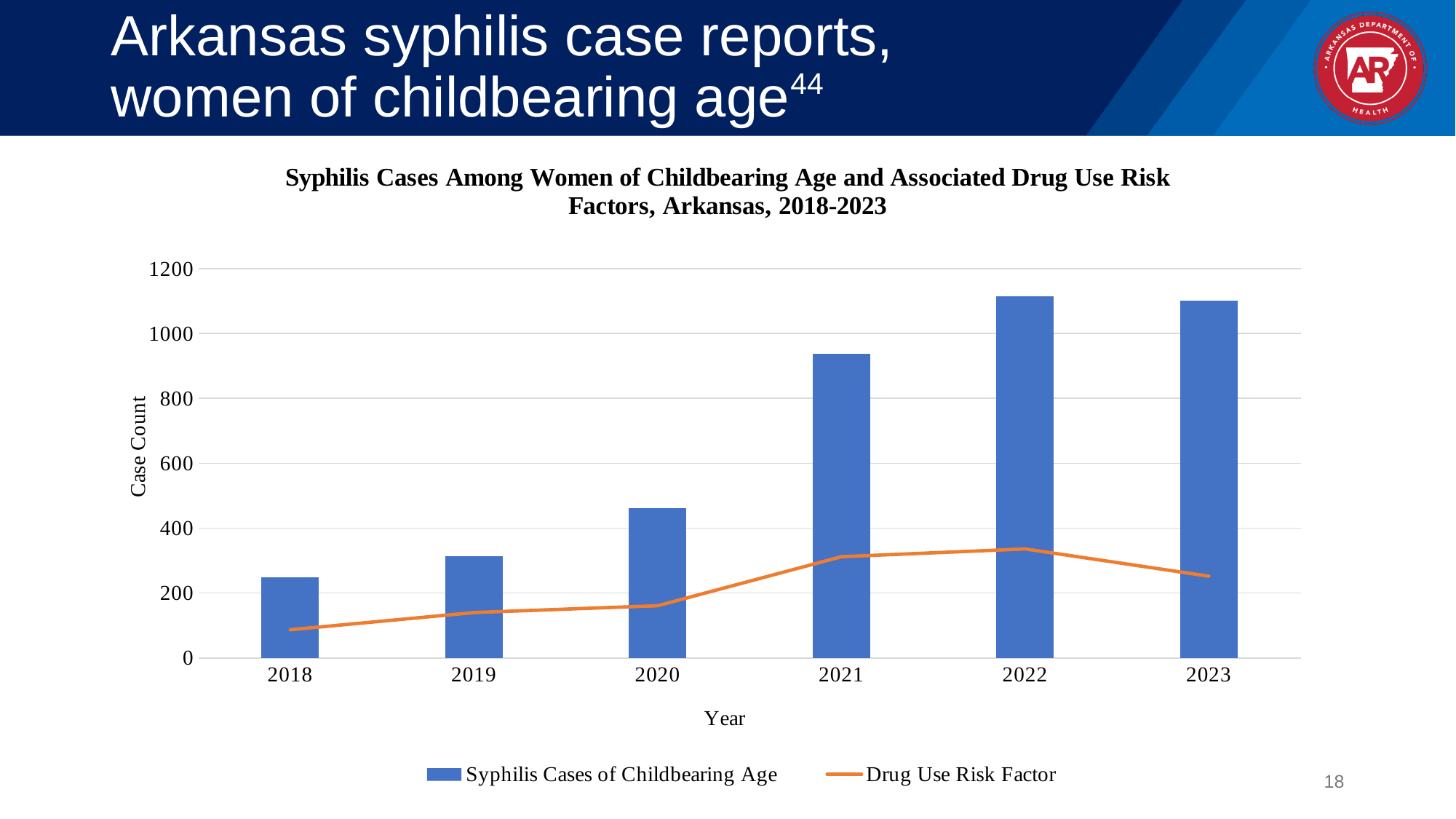
Which is larger: Syphilis Cases of Childbearing Age in 2020 or in 2021? 2021 Is the value for Drug Use Risk Factor in 2018 greater or less than 200? less Which year has the lowest value for Drug Use Risk Factor? 2018 Is the value for Syphilis Cases of Childbearing Age in 2019 greater or less than 400? less What is the label of the y axis? Case Count How many series does the chart legend list? 2 Which year has the lowest value for Syphilis Cases of Childbearing Age? 2018 What kind of chart is shown on the slide? A combination bar and line chart Do the Syphilis Cases of Childbearing Age bars rise or fall from 2018 to 2022? rise Is the value for Syphilis Cases of Childbearing Age in 2021 greater or less than 800? greater How many years are shown on the x axis of the chart? 6